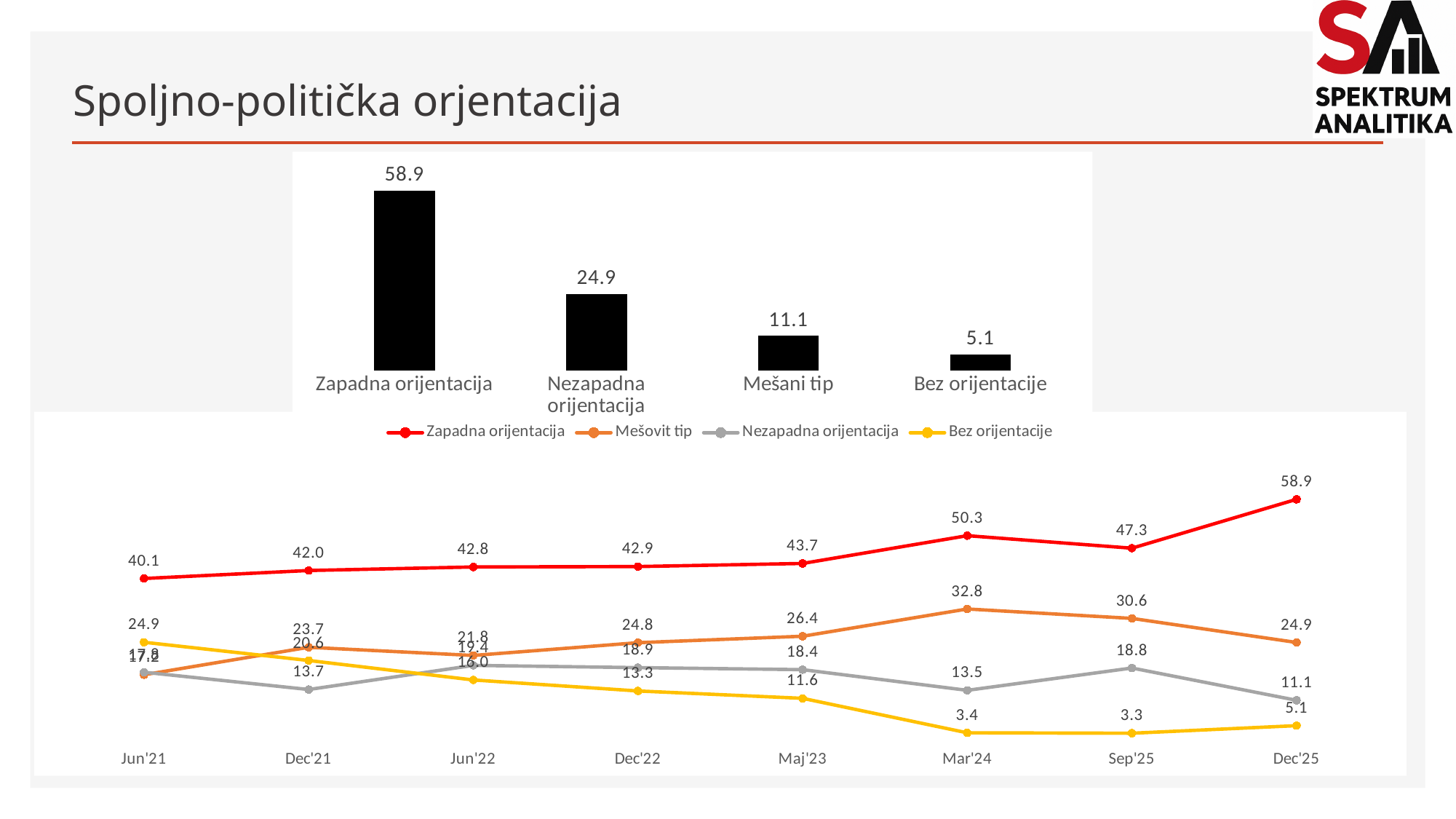
On the line chart at the bottom of the slide, does the Bez orijentacije series generally rise or fall from Jun'21 to Mar'24? Fall On the line chart at the bottom of the slide, what is the value for Zapadna orijentacija at Mar'24? 50.3 On the line chart at the bottom of the slide, which is larger at Dec'25: Mešovit tip or Nezapadna orijentacija? Mešovit tip On the bar chart at the top of the slide, what is the value for Zapadna orijentacija? 58.9 On the bar chart at the top of the slide, what is the difference between Nezapadna orijentacija and Mešani tip? 13.8 On the line chart at the bottom of the slide, what is the value for Bez orijentacije at Sep'25? 3.3 On the bar chart at the top of the slide, how many categories are shown? 4 On the bar chart at the top of the slide, which category has the lowest value? Bez orijentacije On the line chart at the bottom of the slide, how many series does the legend list? 4 On the line chart at the bottom of the slide, how many time points are shown on the x axis? 8 On the line chart at the bottom of the slide, what is the difference between the Zapadna orijentacija values at Dec'25 and Sep'25? 11.6 What kind of chart is the top chart on the slide? Bar chart